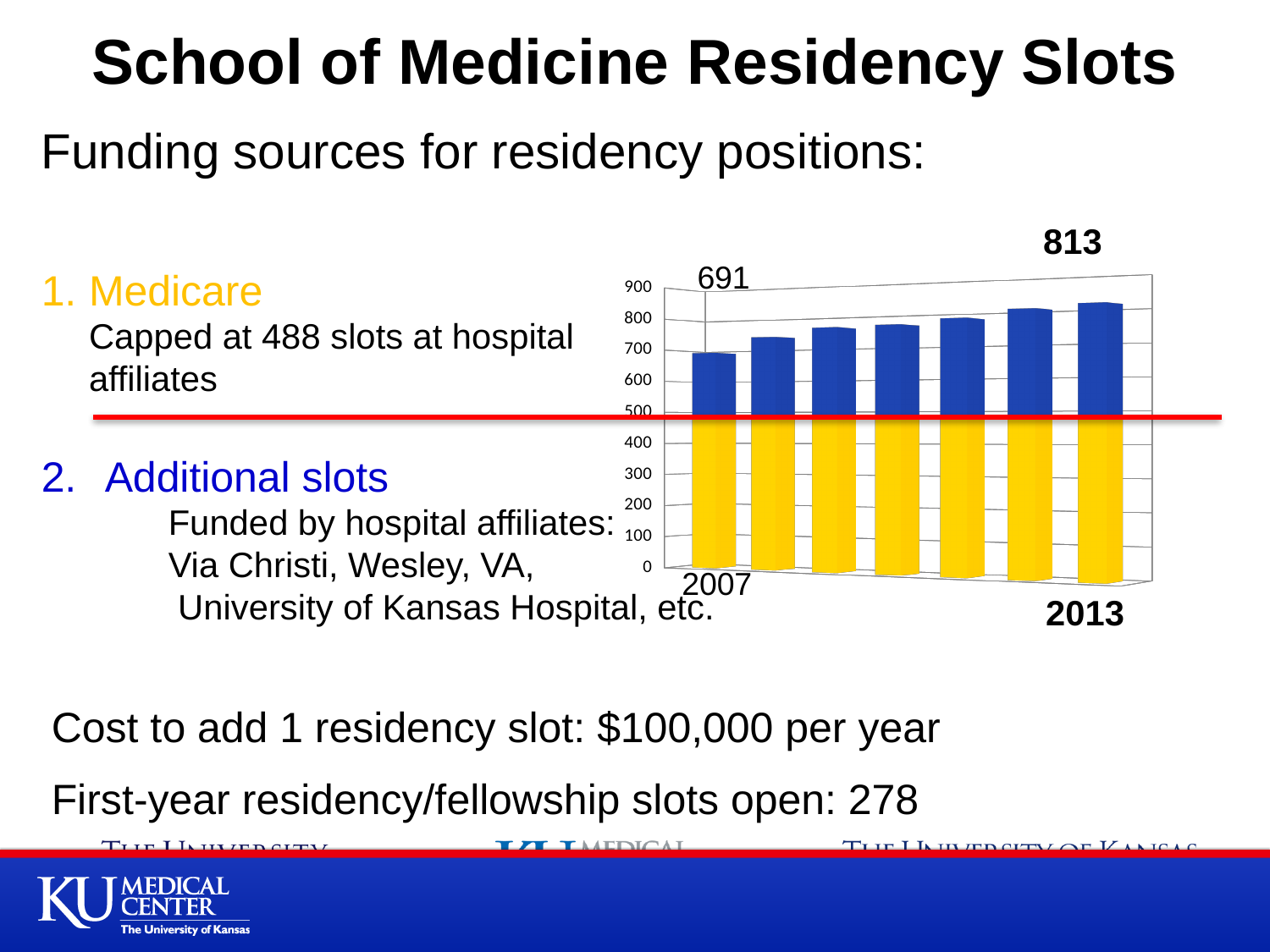
Is the total for the fourth bar from the left greater or less than 700? greater Which year has the highest total of residency slots? 2013 What is the highest value shown on the vertical axis? 900 What kind of chart is shown on the slide? bar chart By how much did the total residency slots increase from 2007 to 2013? 122 What two colours are used for the stacked segments of each bar? yellow and blue How many bars (years) are plotted in the chart? 7 Do the bar totals rise or fall from 2007 to 2013? rise Which year has the lowest total of residency slots? 2007 What is the total number of residency slots shown for 2013? 813 What is the total number of residency slots shown for 2007? 691 Which is larger, the total for 2007 or the total for 2013? 2013